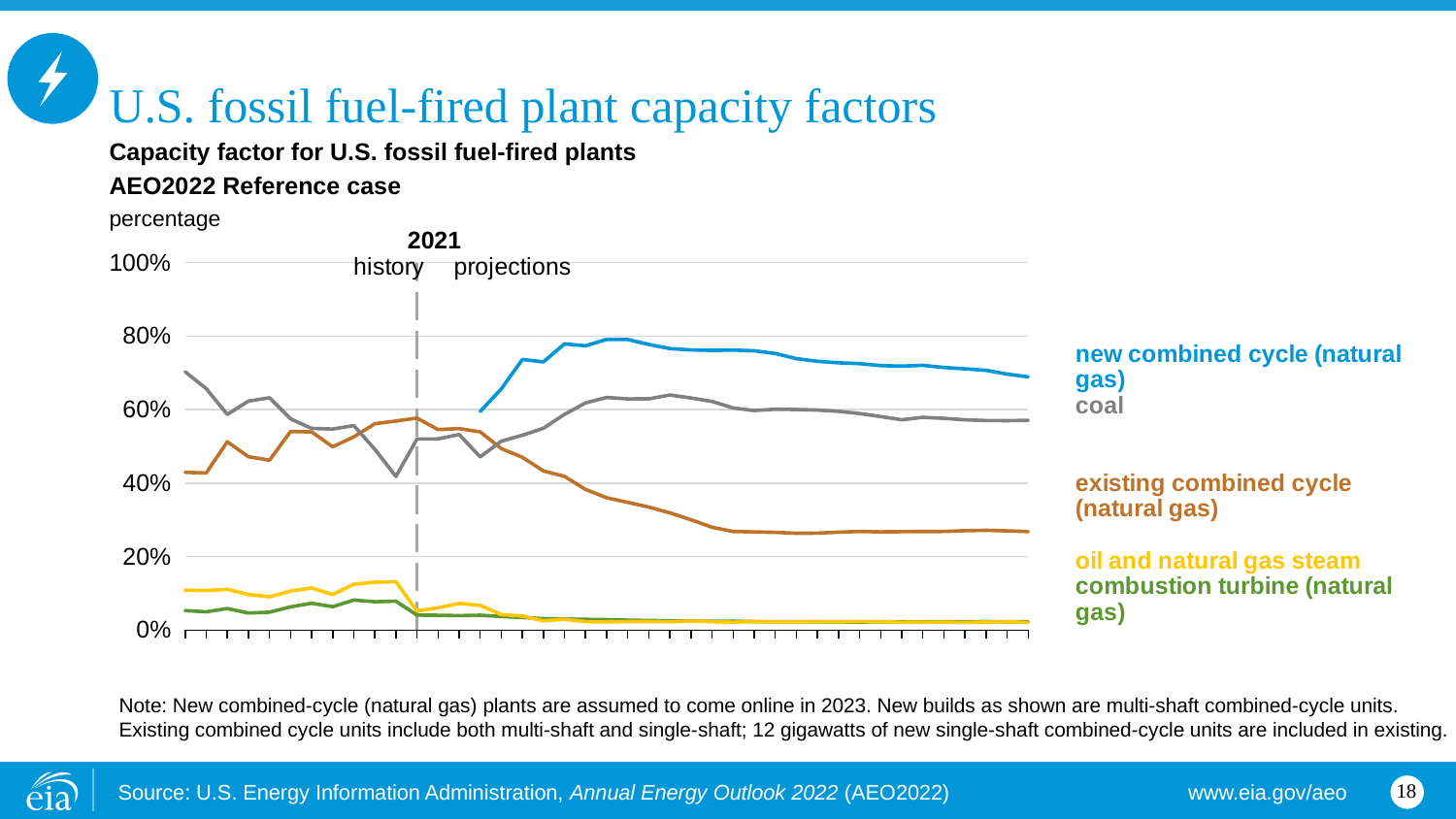
Is the coal value at the 2021 dividing line greater or less than 40%? greater Which series has the lowest capacity factor at the start of the history period? combustion turbine (natural gas) At the end of the projection period, which is larger: coal or existing combined cycle (natural gas)? coal Which series has the highest capacity factor at the end of the projection period? new combined cycle (natural gas) What kind of chart is shown on the slide? line chart How many series does the chart's legend list? 5 What unit is the vertical axis measured in, according to the axis label? percentage At the start of the history period, which is larger: coal or existing combined cycle (natural gas)? coal Is the value for existing combined cycle (natural gas) at the end of the projection period greater or less than 40%? less Is the peak value of the new combined cycle (natural gas) series greater or less than 60%? greater What year separates history from projections on the chart? 2021 Over the projection period, does the existing combined cycle (natural gas) capacity factor rise or fall? fall